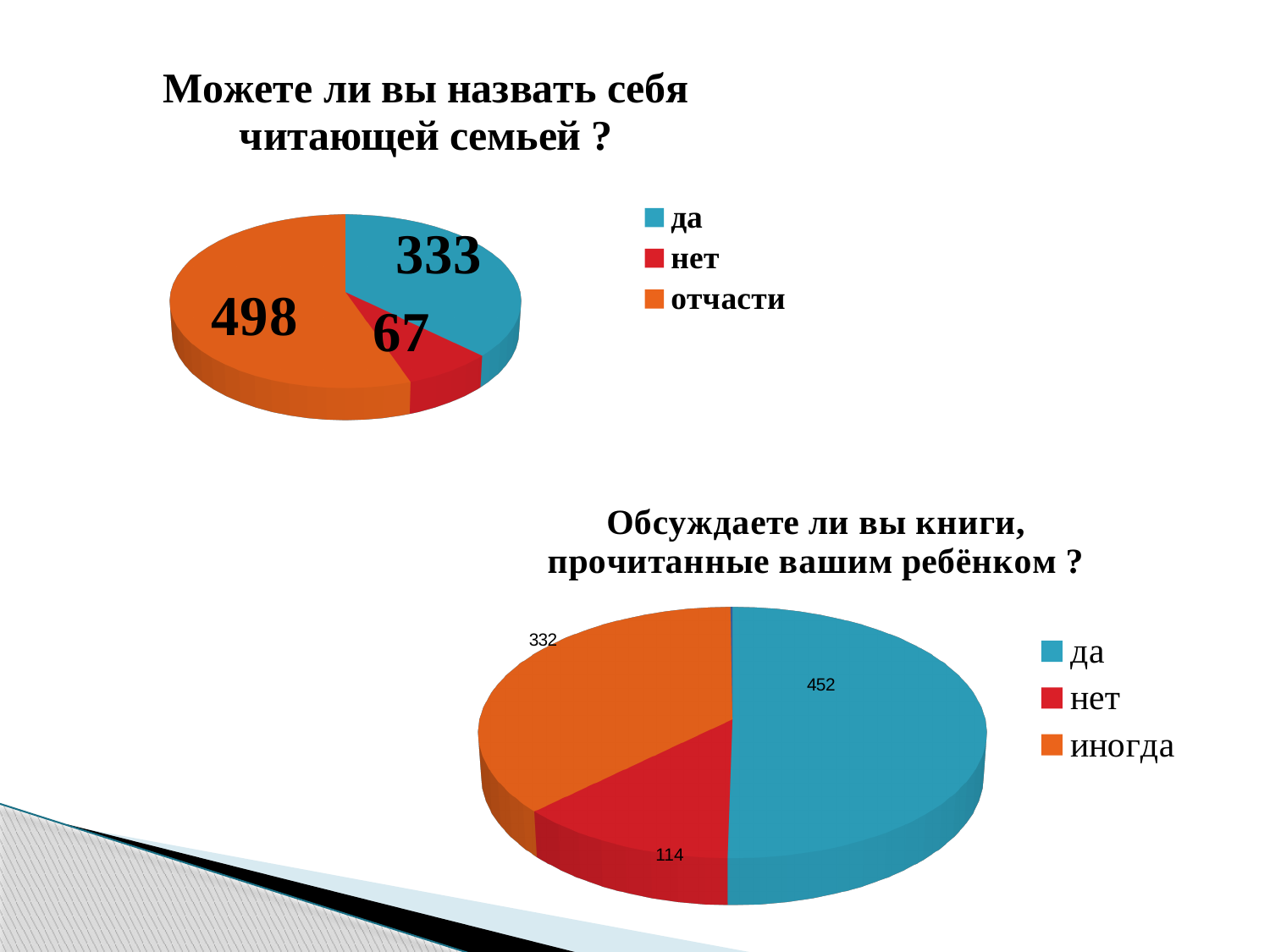
How many categories does the legend of the top chart list? 3 In the chart titled "Можете ли вы назвать себя читающей семьей ?", what is the difference between the values for "отчасти" and "да"? 165 What type of chart is the bottom chart on the slide? Pie chart In the chart titled "Обсуждаете ли вы книги, прочитанные вашим ребёнком ?", which is larger, "да" or "иногда"? да In the chart titled "Можете ли вы назвать себя читающей семьей ?", which category has the largest slice? отчасти In the chart titled "Можете ли вы назвать себя читающей семьей ?", which category has the smallest slice? нет In the chart titled "Обсуждаете ли вы книги, прочитанные вашим ребёнком ?", which category has the smallest slice? нет In the chart titled "Обсуждаете ли вы книги, прочитанные вашим ребёнком ?", what is the value for "да"? 452 In the chart titled "Обсуждаете ли вы книги, прочитанные вашим ребёнком ?", what is the value for "иногда"? 332 In the chart titled "Можете ли вы назвать себя читающей семьей ?", what is the value for "нет"? 67 In the chart titled "Обсуждаете ли вы книги, прочитанные вашим ребёнком ?", what is the difference between the values for "да" and "нет"? 338 In the chart titled "Можете ли вы назвать себя читающей семьей ?", what is the value for "отчасти"? 498